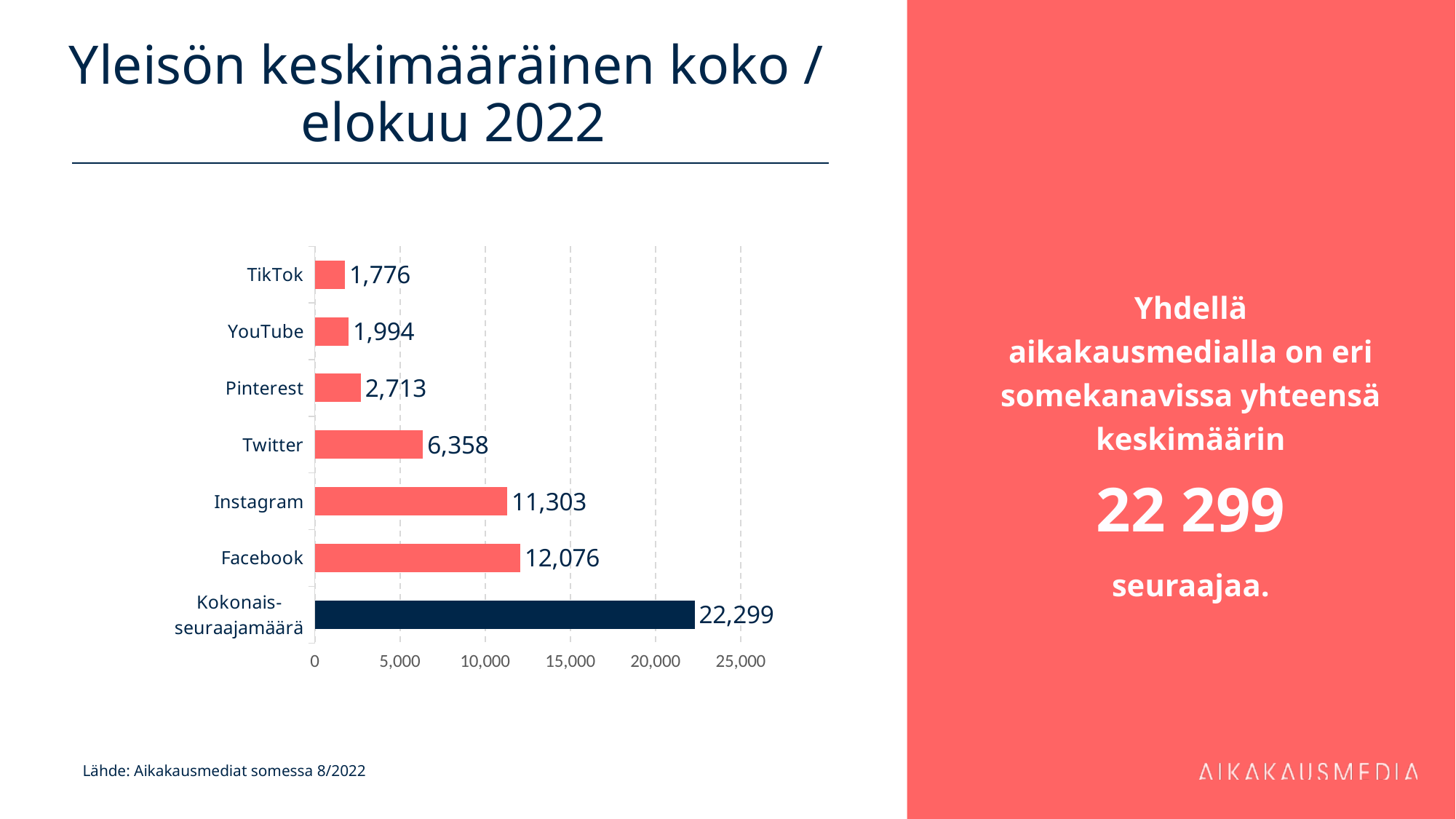
How many categories are shown in the chart? 7 What is the value for Facebook? 12,076 What is the title of the chart? Yleisön keskimääräinen koko / elokuu 2022 What is the difference between the values for Facebook and Instagram? 773 What is the value for TikTok? 1,776 What kind of chart is shown on the slide? bar chart Is the value for Twitter greater or less than 5,000? greater What is the value for Kokonais-seuraajamäärä? 22,299 What is the value for Instagram? 11,303 Which is larger, the value for Twitter or the value for Pinterest? Twitter Which category has the highest value? Kokonais-seuraajamäärä Which category has the lowest value? TikTok